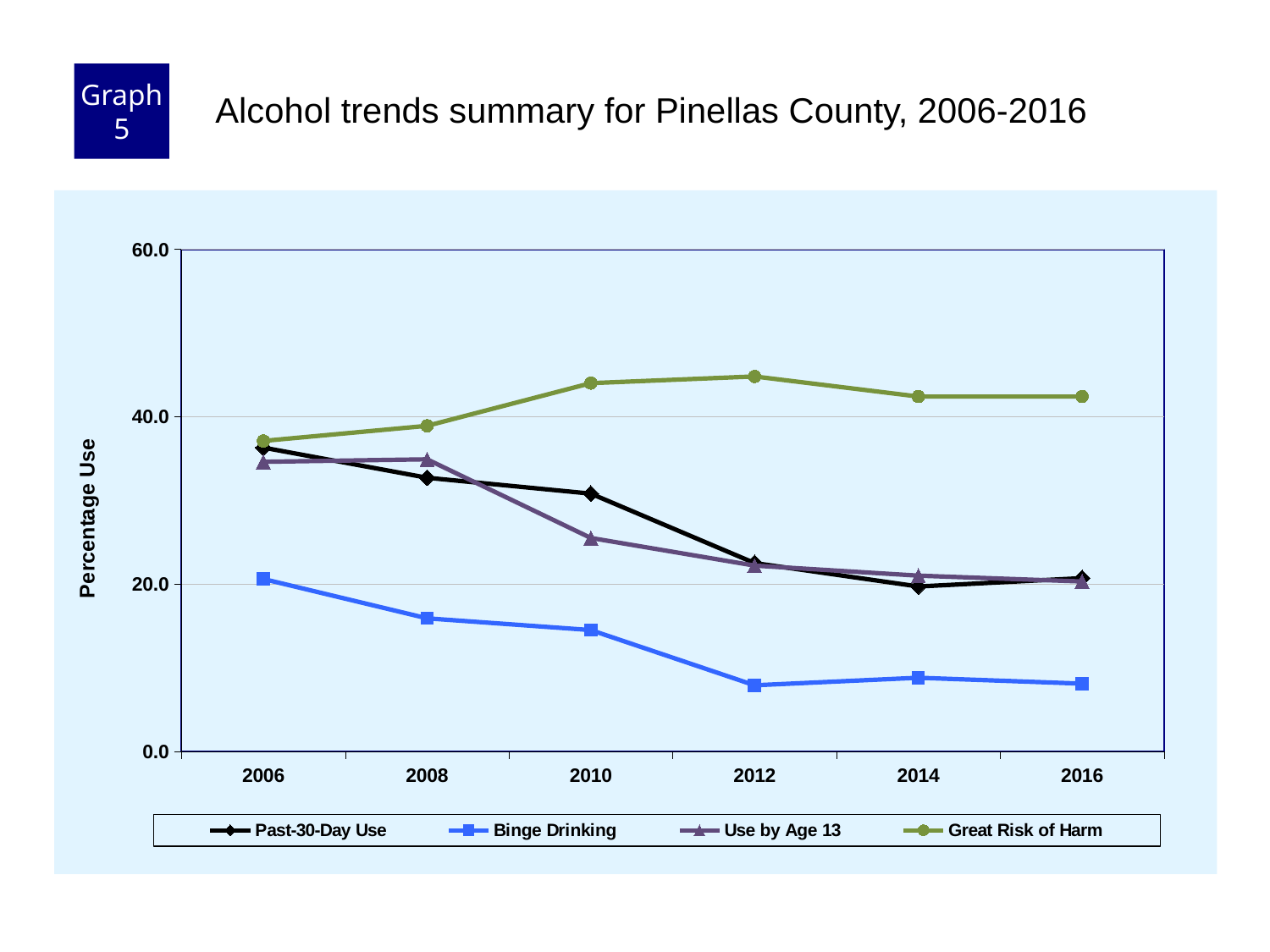
Is the value for Past-30-Day Use in 2006 greater or less than 40.0? less Is the value for Binge Drinking in 2008 greater or less than 20.0? less How many years are plotted along the x axis? 6 Is the value for Great Risk of Harm in 2012 greater or less than 40.0? greater Does the Binge Drinking series rise or fall from 2006 to 2016? fall In 2010, which is larger: Past-30-Day Use or Use by Age 13? Past-30-Day Use Which series has the highest value in 2016? Great Risk of Harm Does the Great Risk of Harm series rise or fall overall from 2006 to 2016? rise Which series has the lowest value in 2016? Binge Drinking What is the label on the y axis? Percentage Use How many series does the legend list? 4 What kind of chart is shown on the slide? line chart